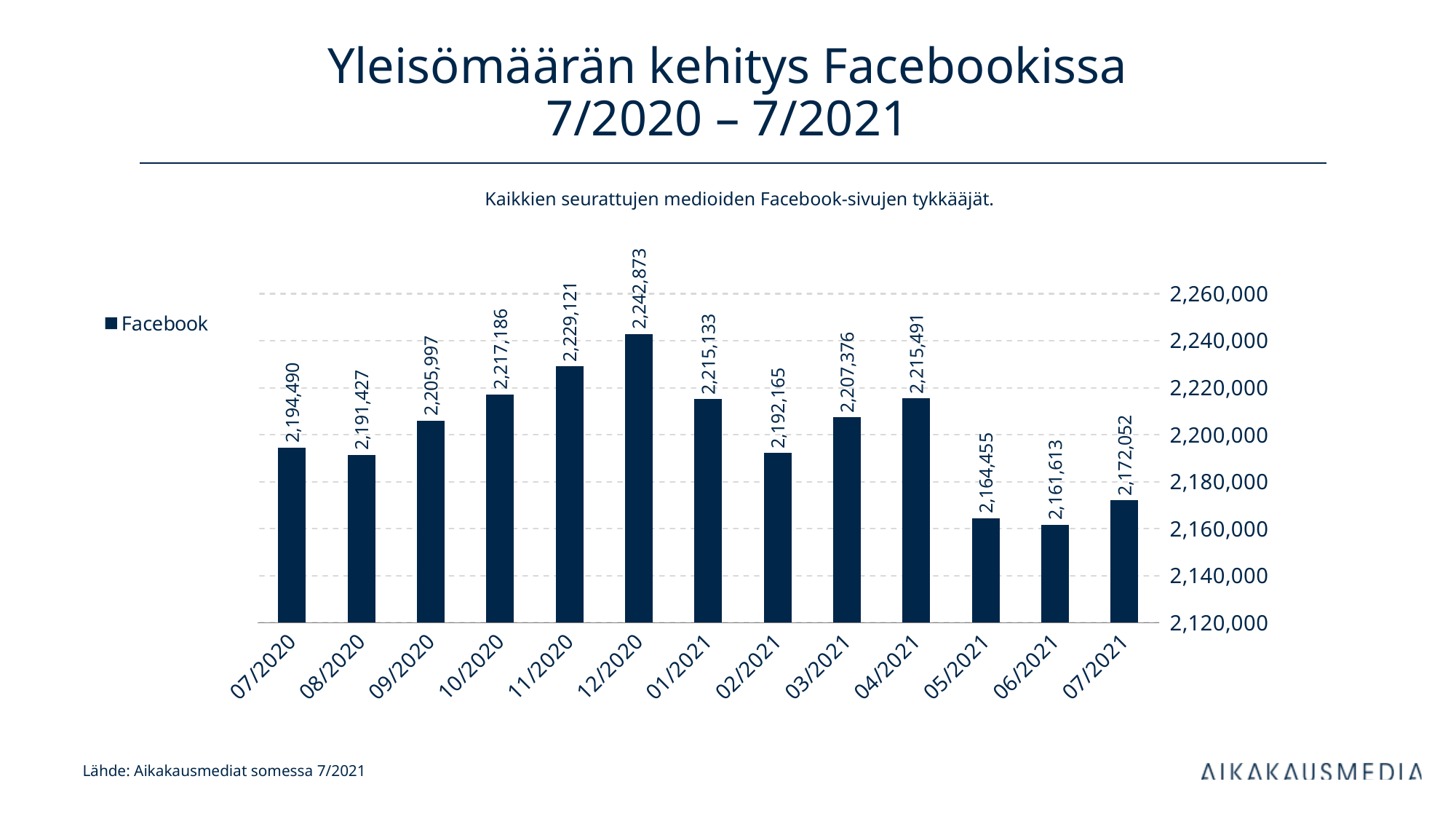
What is the difference between the values for 12/2020 and 07/2020? 48,383 What is the value for 07/2021? 2,172,052 What kind of chart is shown on the slide? bar chart Which month has the highest value? 12/2020 What is the difference between the values for 07/2021 and 06/2021? 10,439 How many series does the legend list? 1 Which is larger, the value for 11/2020 or the value for 01/2021? 11/2020 Is the value for 05/2021 greater or less than 2,180,000? less How many months are shown on the x axis? 13 Which month has the lowest value? 06/2021 What is the value for 12/2020? 2,242,873 What is the value for 03/2021? 2,207,376